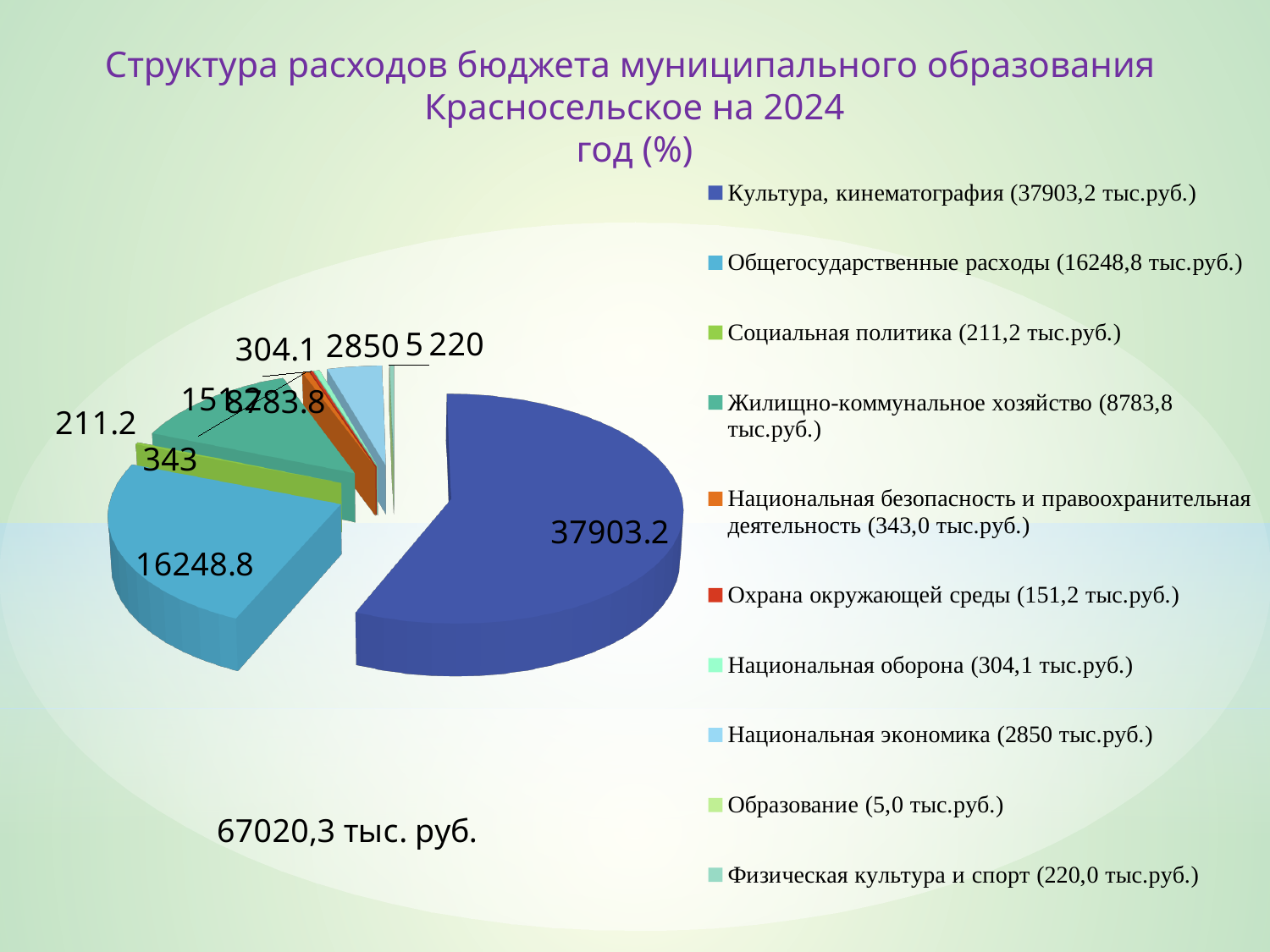
What is the value shown for Национальная экономика? 2850 What kind of chart is shown on the slide? pie chart What is the value shown for Культура, кинематография? 37903.2 Which is larger: Национальная безопасность и правоохранительная деятельность or Национальная оборона? Национальная безопасность и правоохранительная деятельность What total amount is printed below the pie chart? 67020,3 тыс. руб. Which category has the largest slice of the pie? Культура, кинематография How many categories does the pie chart show? 10 Which is larger: Общегосударственные расходы or Жилищно-коммунальное хозяйство? Общегосударственные расходы What is the difference between the values for Национальная безопасность и правоохранительная деятельность and Национальная оборона? 38.9 What is the value shown for Общегосударственные расходы? 16248.8 What is the difference between the values for Культура, кинематография and Общегосударственные расходы? 21654.4 Which category has the smallest value in the pie chart? Образование